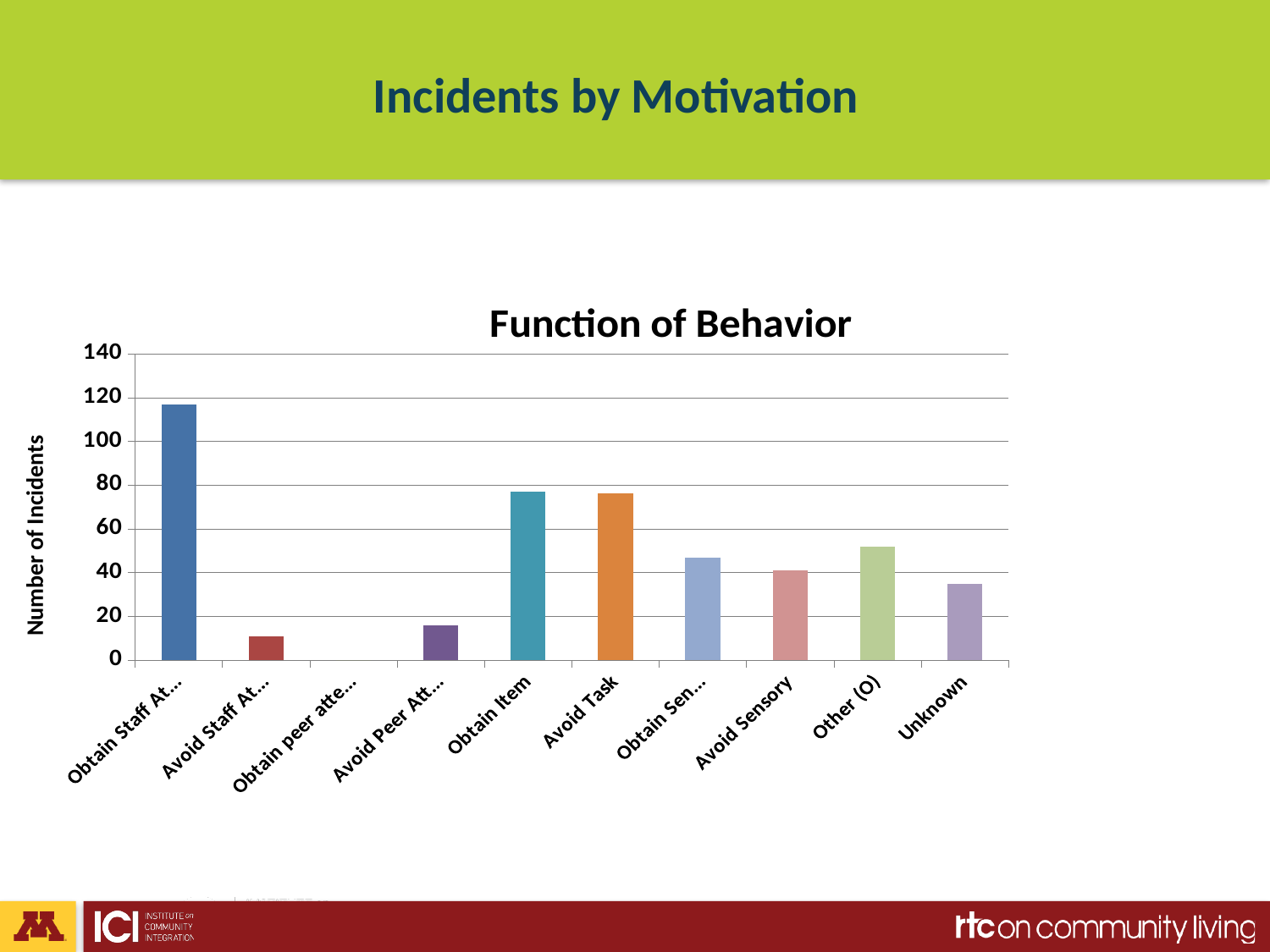
Which has the larger value, Other (O) or Unknown? Other (O) What type of chart is shown on the slide? bar chart What is the label on the vertical axis of the chart? Number of Incidents How many categories are shown on the x axis of the chart? 10 Is the value for Avoid Sensory greater or less than 60? less Is the value for Unknown greater or less than 60? less Which has the larger value, Obtain Item or Avoid Sensory? Obtain Item Is the value for Obtain Item greater or less than 60? greater What is the title of the chart? Function of Behavior